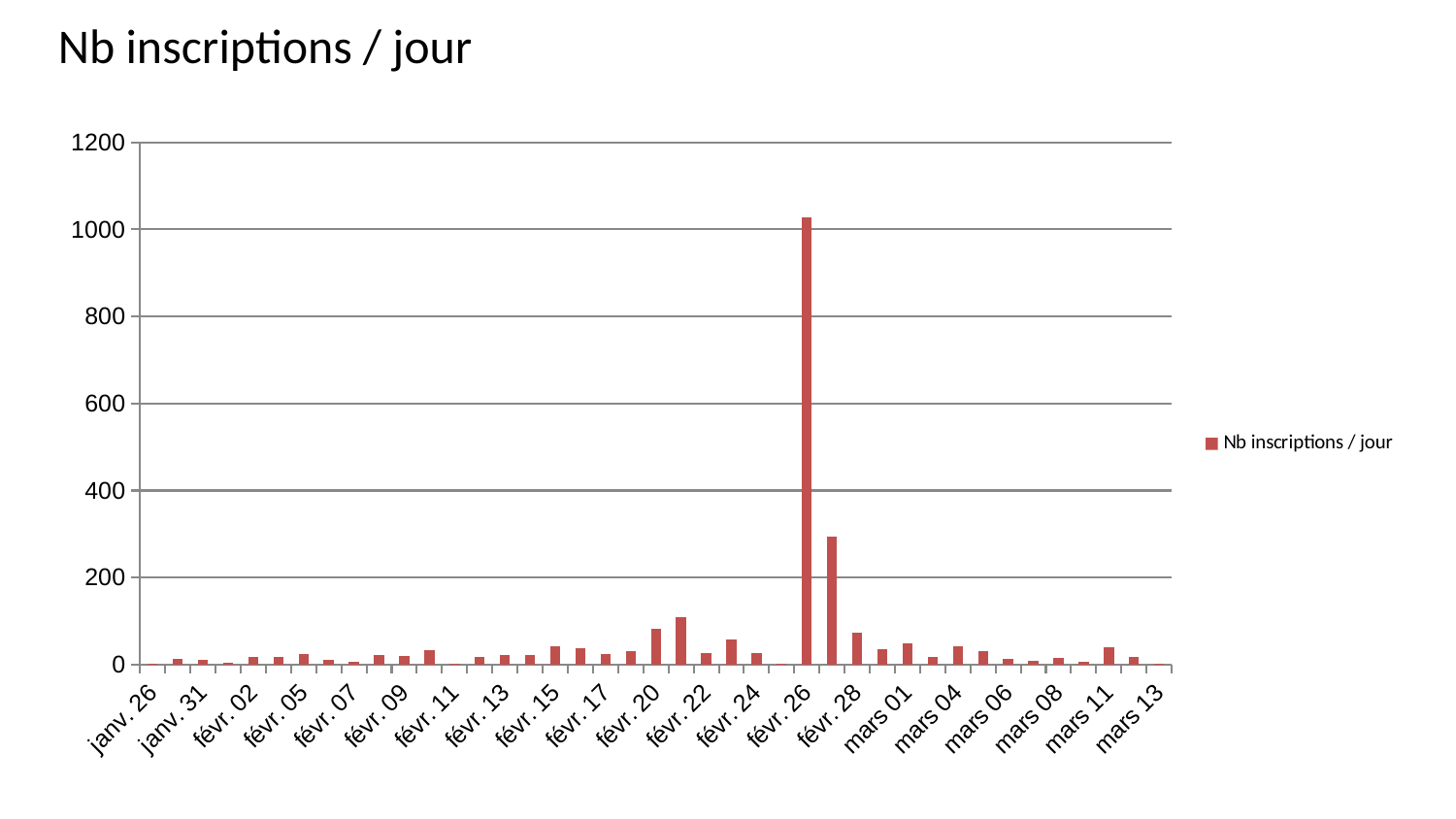
Which is larger, the value for févr. 22 or the value for mars 13? févr. 22 How many series does the legend list? 1 Is the value for févr. 28 greater or less than 200? less How many date labels are shown on the x axis? 21 What is the name of the series shown in the legend? Nb inscriptions / jour What is the maximum value shown on the y axis? 1200 Which date has the highest number of inscriptions? févr. 26 Is the value for févr. 26 greater or less than 800? greater What is the title of the chart? Nb inscriptions / jour Is the value for févr. 20 greater or less than 200? less Which is larger, the value for févr. 26 or the value for mars 11? févr. 26 What kind of chart is shown on the slide? bar chart